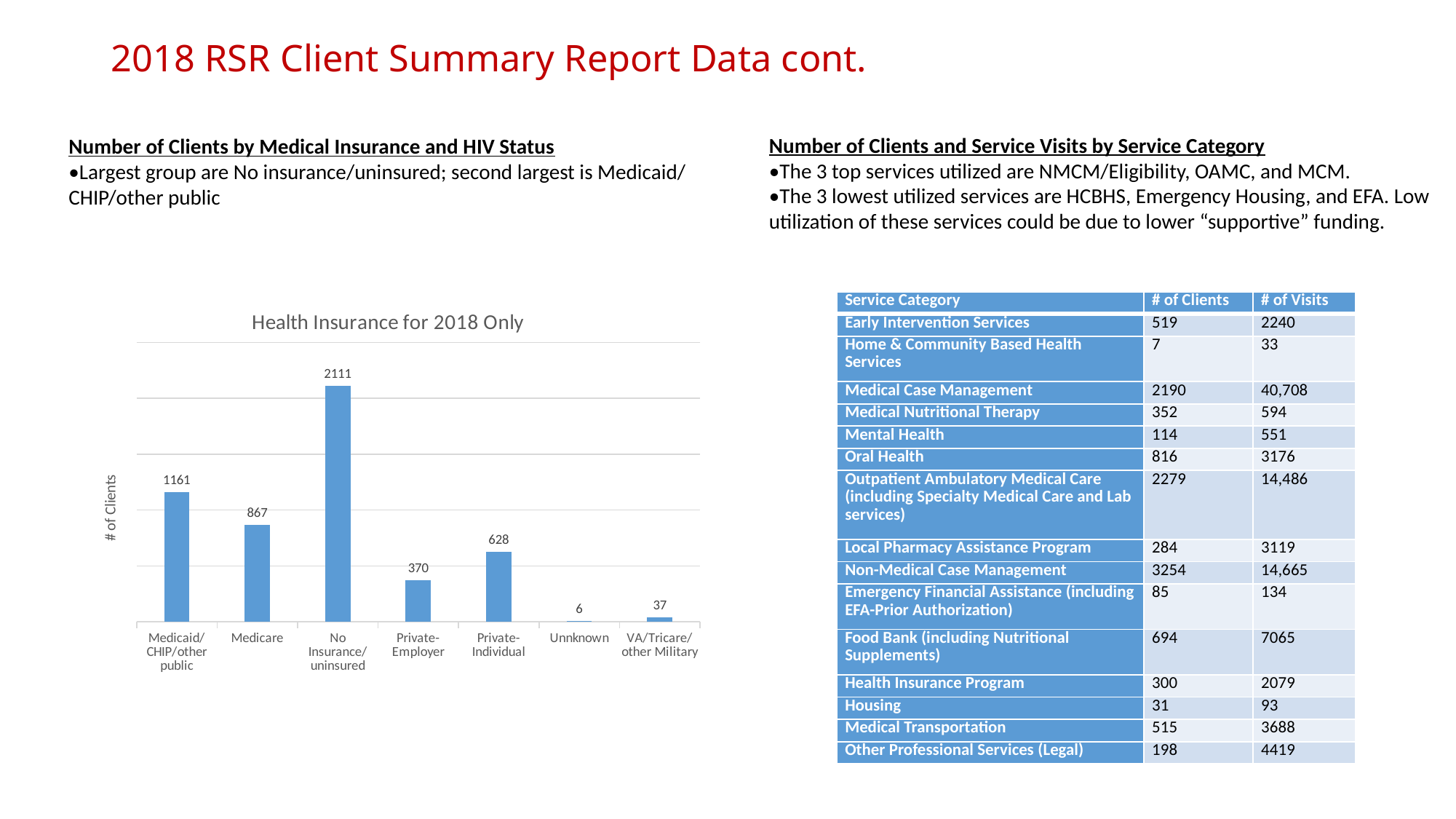
What is the value for Private-Individual in the Health Insurance for 2018 Only chart? 628 What kind of chart is the Health Insurance for 2018 Only chart? Bar chart Which category has the lowest value in the Health Insurance for 2018 Only chart? Unnknown What is the value for Medicare in the Health Insurance for 2018 Only chart? 867 What is the difference between the values for Medicaid/CHIP/other public and Medicare in the Health Insurance for 2018 Only chart? 294 How many categories are shown in the Health Insurance for 2018 Only chart? 7 What is the y-axis label of the Health Insurance for 2018 Only chart? # of Clients Which is larger in the Health Insurance for 2018 Only chart, Medicare or Private-Individual? Medicare What is the value for VA/Tricare/other Military in the Health Insurance for 2018 Only chart? 37 What is the difference between the values for Private-Individual and Private-Employer in the Health Insurance for 2018 Only chart? 258 Which category has the highest value in the Health Insurance for 2018 Only chart? No Insurance/uninsured What is the value for No Insurance/uninsured in the Health Insurance for 2018 Only chart? 2111